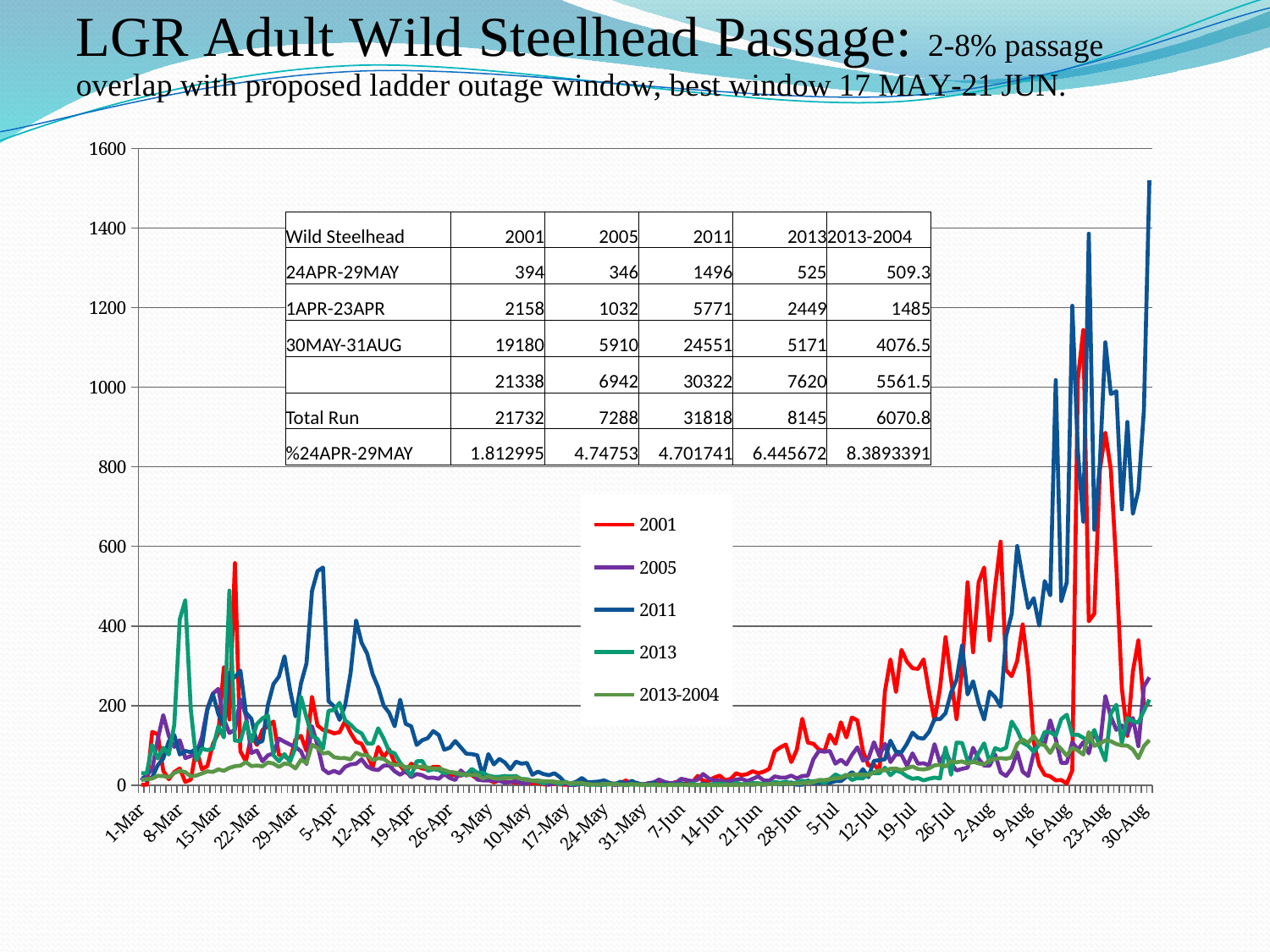
How many series does the chart legend list? 5 Do the values of the 2011 series rise or fall from 5-Jul to 30-Aug overall? rise Is the highest value of the 2011 series greater or less than 1400? greater Around 24-May, are the values of all series greater or less than 200? less Which series has a higher peak, 2011 or 2005? 2011 What kind of chart is shown on the slide? line chart What colour is the line for the 2001 series? red Which series reaches the highest value on the chart? 2011 Does the 2013-2004 series ever rise above 200 on the chart? No What is the maximum value shown on the vertical axis? 1600